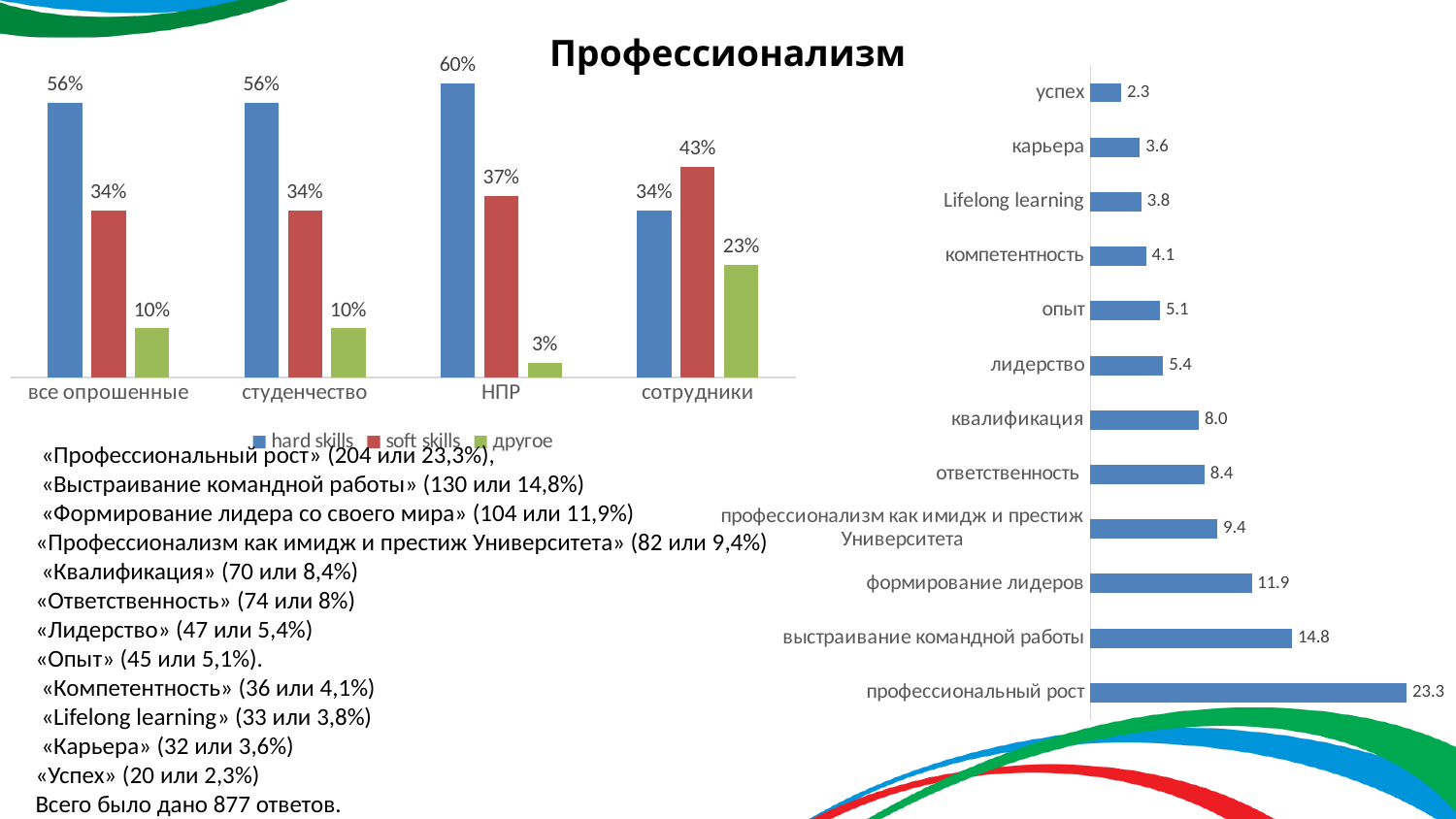
In the left chart, what is the difference between the hard skills and soft skills values for все опрошенные? 22% In the right chart, which category has the highest value? профессиональный рост In the left chart, how many series does the legend list? 3 In the left chart, which category has the lowest другое value? НПР In the right chart, what is the value for выстраивание командной работы? 14.8 In the left chart, for сотрудники, which is larger: hard skills or soft skills? soft skills In the left chart, what is the другое value for сотрудники? 23% In the left chart, what is the hard skills value for НПР? 60% In the left chart, how many categories are shown on the x axis? 4 What kind of chart is the right chart? bar chart In the right chart, which category has the lowest value? успех In the right chart, what is the difference between профессиональный рост and формирование лидеров? 11.4